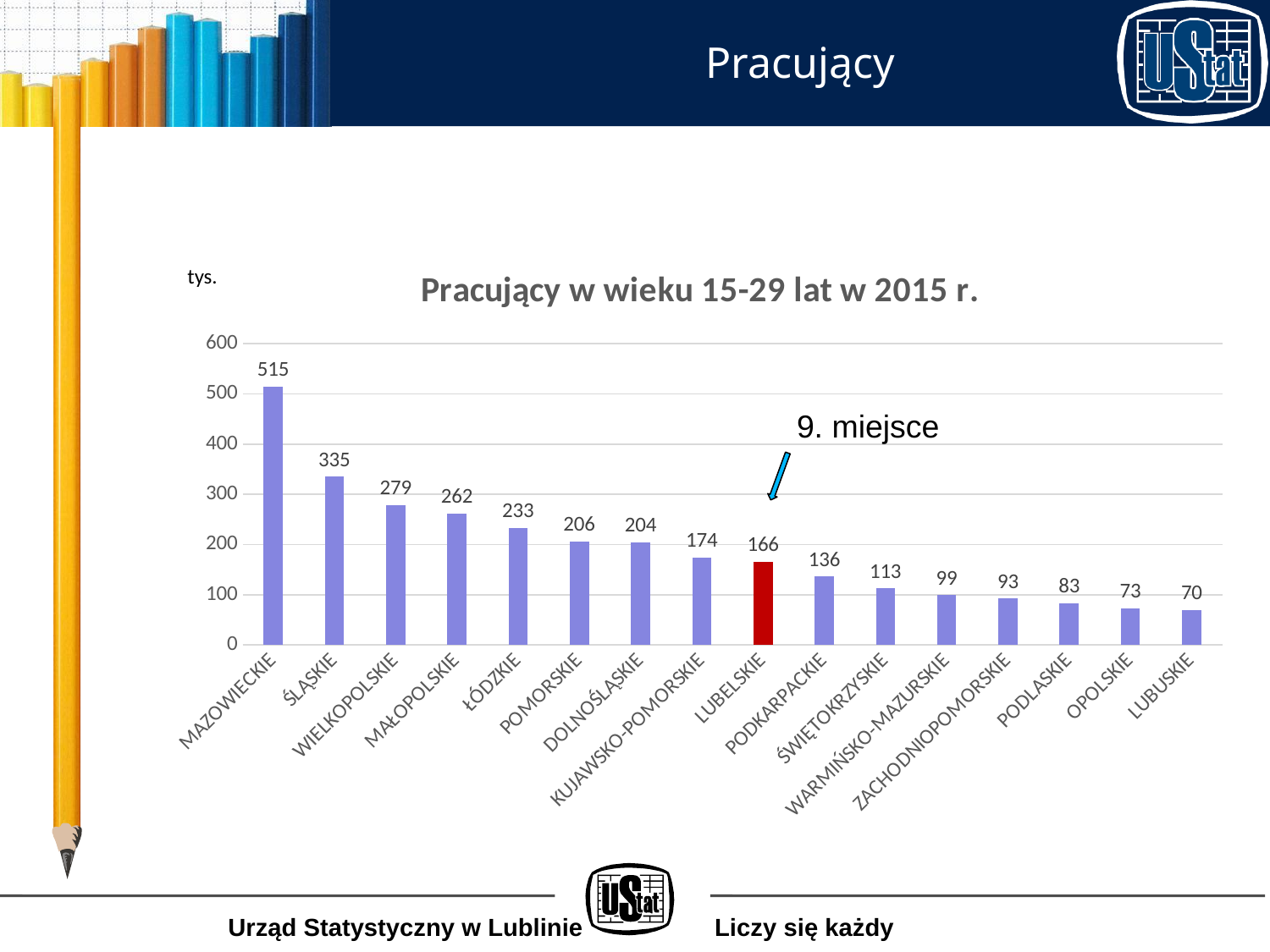
What is the title of the chart? Pracujący w wieku 15-29 lat w 2015 r. What kind of chart is this? bar chart What is the difference between the values for ŚLĄSKIE and WIELKOPOLSKIE? 56 Which voivodeship has the highest value? MAZOWIECKIE What is the value for PODKARPACKIE? 136 Do the values rise or fall from left to right along the x axis? fall How many voivodeships are shown on the x axis? 16 What is the value for LUBELSKIE? 166 Which voivodeship has the lowest value? LUBUSKIE Is the value for MAŁOPOLSKIE greater or less than 300? less Which is larger, the value for POMORSKIE or the value for ŁÓDZKIE? ŁÓDZKIE What is the value for MAZOWIECKIE? 515